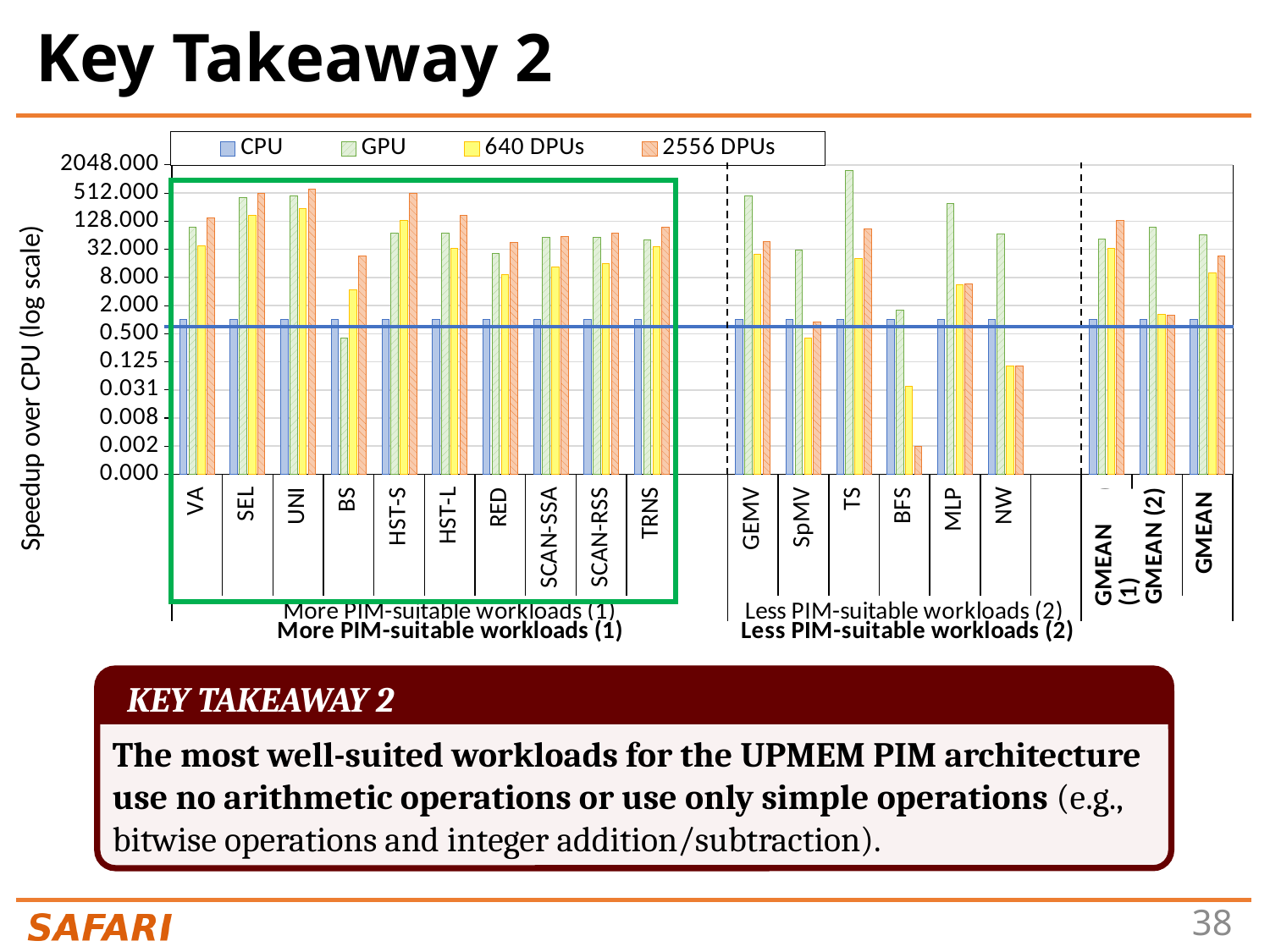
For the BS workload, which is larger: the GPU value or the 2556 DPUs value? 2556 DPUs Which workload has the highest GPU bar in the chart? TS How many series does the chart's legend list? 4 For the GEMV workload, which is larger: the GPU value or the 640 DPUs value? GPU Which series has the tallest bar for the TS workload? GPU Is the 640 DPUs value for VA greater or less than 8? greater What is the label of the y axis of the chart? Speedup over CPU (log scale) Is the GPU value for TS greater or less than 512? greater Is the GPU value for GEMV greater or less than 128? greater What kind of chart is shown on the slide? bar chart